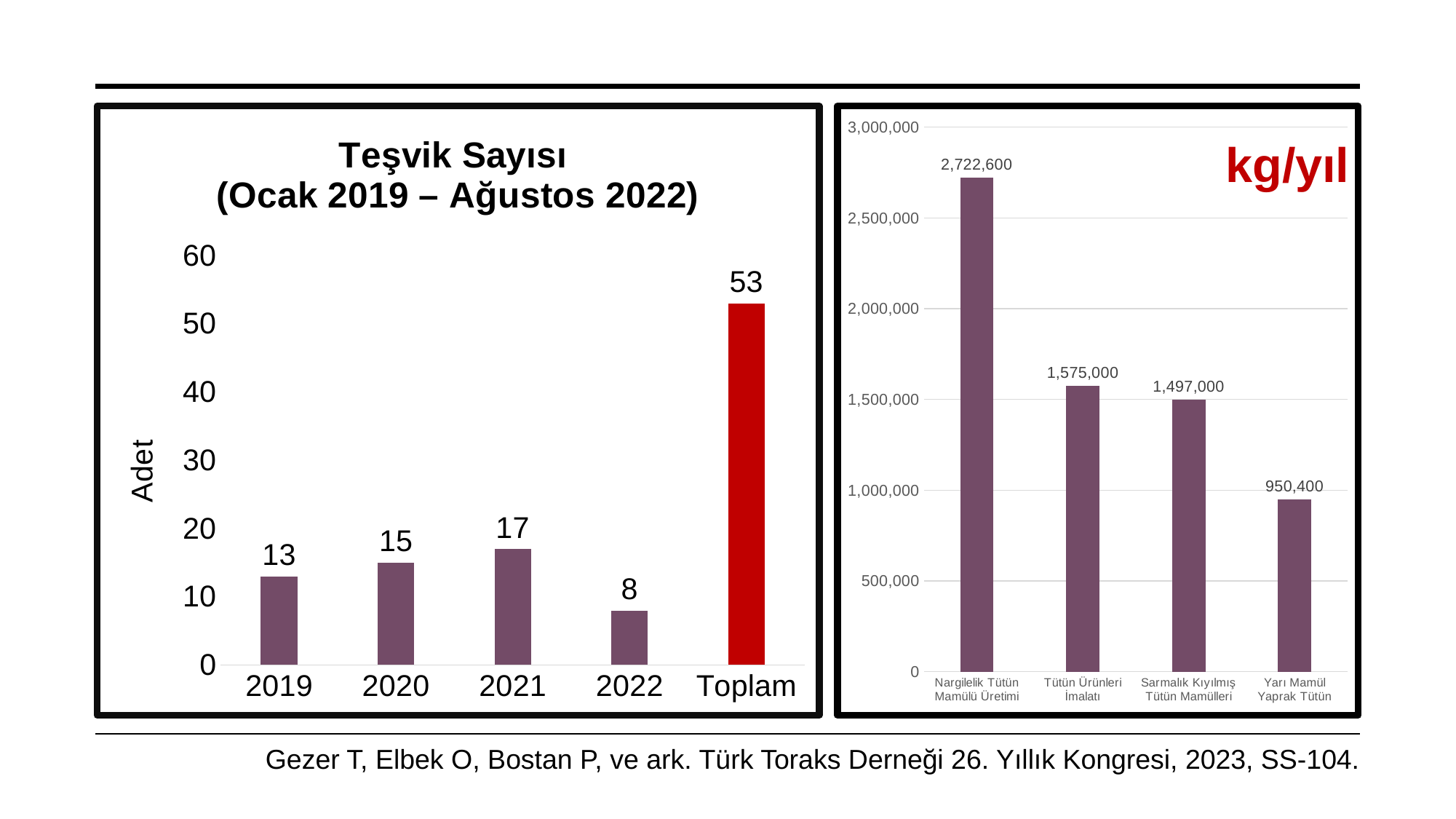
In the left chart titled 'Teşvik Sayısı (Ocak 2019 – Ağustos 2022)', which is larger, the value for 2020 or the value for 2022? 2020 In the right chart labelled 'kg/yıl', what is the value for Nargilelik Tütün Mamülü Üretimi? 2,722,600 In the right chart labelled 'kg/yıl', what is the value for Yarı Mamül Yaprak Tütün? 950,400 In the left chart titled 'Teşvik Sayısı (Ocak 2019 – Ağustos 2022)', what is the difference between the values for 2021 and 2019? 4 In the left chart titled 'Teşvik Sayısı (Ocak 2019 – Ağustos 2022)', what is the value for Toplam? 53 In the right chart labelled 'kg/yıl', which category has the highest value? Nargilelik Tütün Mamülü Üretimi In the right chart labelled 'kg/yıl', how many categories are shown? 4 In the left chart titled 'Teşvik Sayısı (Ocak 2019 – Ağustos 2022)', what colour is the Toplam bar? Red In the right chart labelled 'kg/yıl', what is the difference between Tütün Ürünleri İmalatı and Sarmalık Kıyılmış Tütün Mamülleri? 78,000 In the left chart titled 'Teşvik Sayısı (Ocak 2019 – Ağustos 2022)', which year from 2019 to 2022 has the lowest value? 2022 In the left chart titled 'Teşvik Sayısı (Ocak 2019 – Ağustos 2022)', what is the value for 2021? 17 In the left chart titled 'Teşvik Sayısı (Ocak 2019 – Ağustos 2022)', what is the label of the y axis? Adet